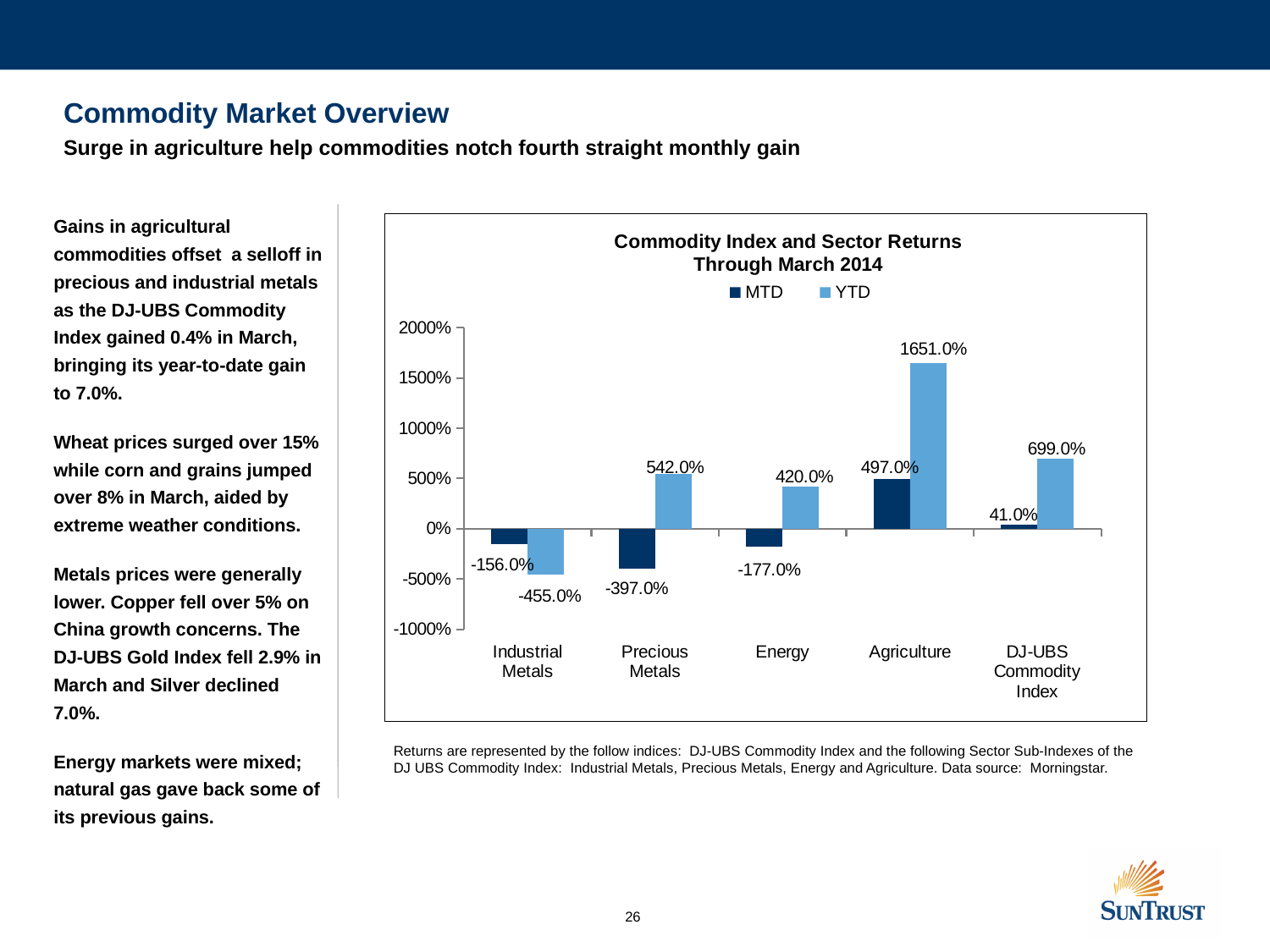
What is the MTD value for Precious Metals? -397.0% What kind of chart is shown on the slide? Bar chart Which category has the highest YTD value? Agriculture Which category has the lowest YTD value? Industrial Metals How many categories are shown on the x axis? 5 What is the difference between the YTD and MTD values for Agriculture? 1154.0% What is the YTD value for Agriculture? 1651.0% Which category has the lowest MTD value? Precious Metals What is the MTD value for Industrial Metals? -156.0% Which is larger, the YTD value for Precious Metals or the YTD value for Energy? Precious Metals What is the YTD value for the DJ-UBS Commodity Index? 699.0% How many series does the legend list? 2